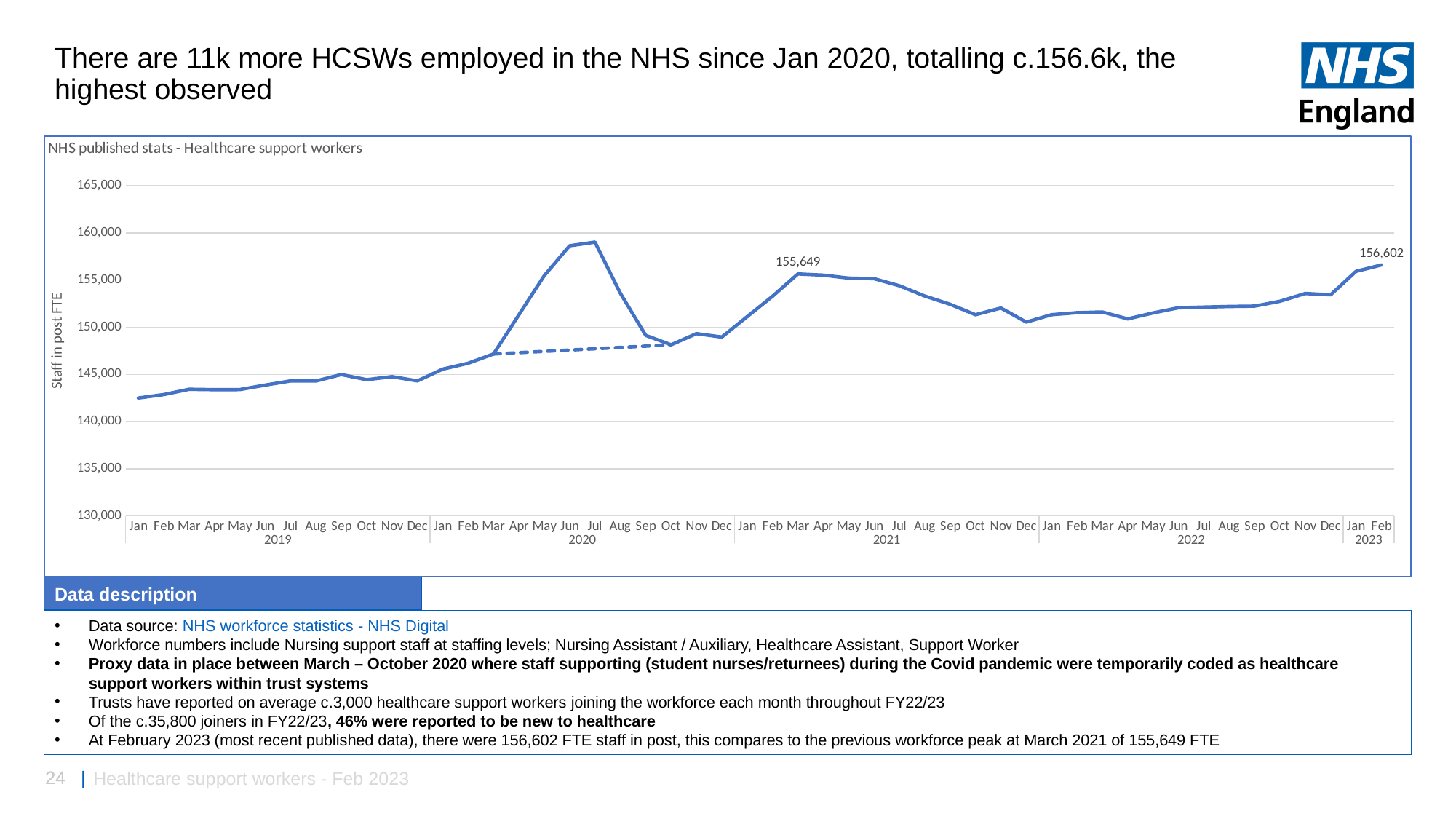
Which is larger, the value for Feb 2023 or the value for Mar 2021? Feb 2023 Overall, do the values rise or fall from Jan 2019 to Feb 2023? rise Is the value for Jul 2020 greater or less than 155,000? greater What is the difference between the Feb 2023 value and the Mar 2021 value? 953 What is the labelled value for Mar 2021? 155,649 How many years are labelled along the x axis? 5 What kind of chart is shown on the slide? line chart Is the value for Jan 2019 greater or less than 145,000? less Which month has the lowest value on the chart? Jan 2019 What is the title of the y axis? Staff in post FTE What is the labelled value for Feb 2023? 156,602 Is the value for Oct 2020 greater or less than 150,000? less